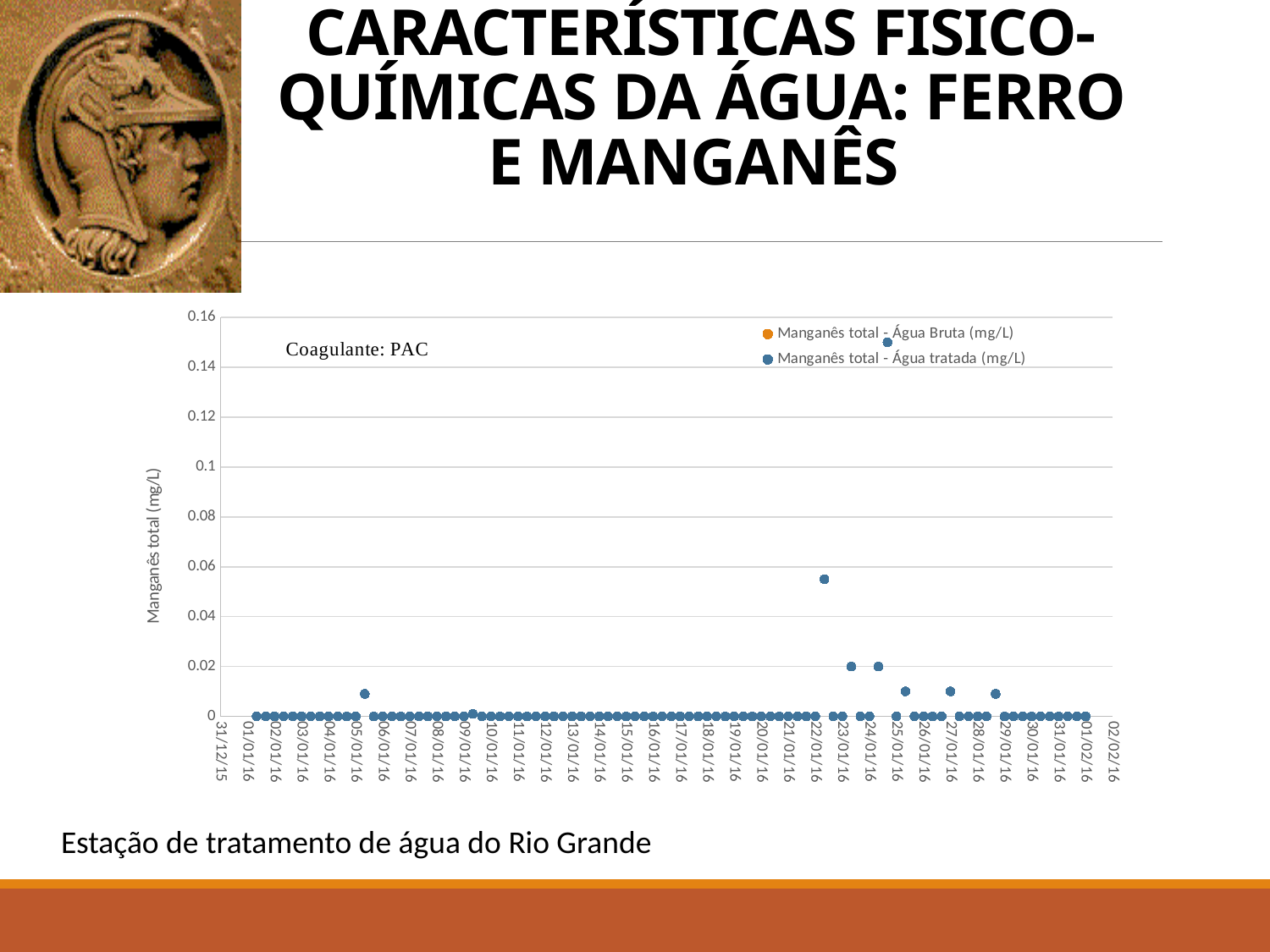
Which is larger: the plotted value near 22/01/16 or the plotted value near 05/01/16? The value near 22/01/16 What is the label of the vertical axis of the chart? Manganês total (mg/L) How many series does the chart legend list? 2 What kind of chart is shown on the slide? Scatter chart Is the plotted value near 22/01/16 greater or less than 0.04? greater Is the highest plotted value on the chart greater or less than 0.14? greater Is the highest plotted value on the chart greater or less than 0.16? less What are the two series named in the chart legend? Manganês total - Água Bruta (mg/L) and Manganês total - Água tratada (mg/L) Do the plotted values stay mostly at 0 or rise steadily across the dates on the x axis? Mostly at 0 What is the maximum value shown on the vertical axis of the chart? 0.16